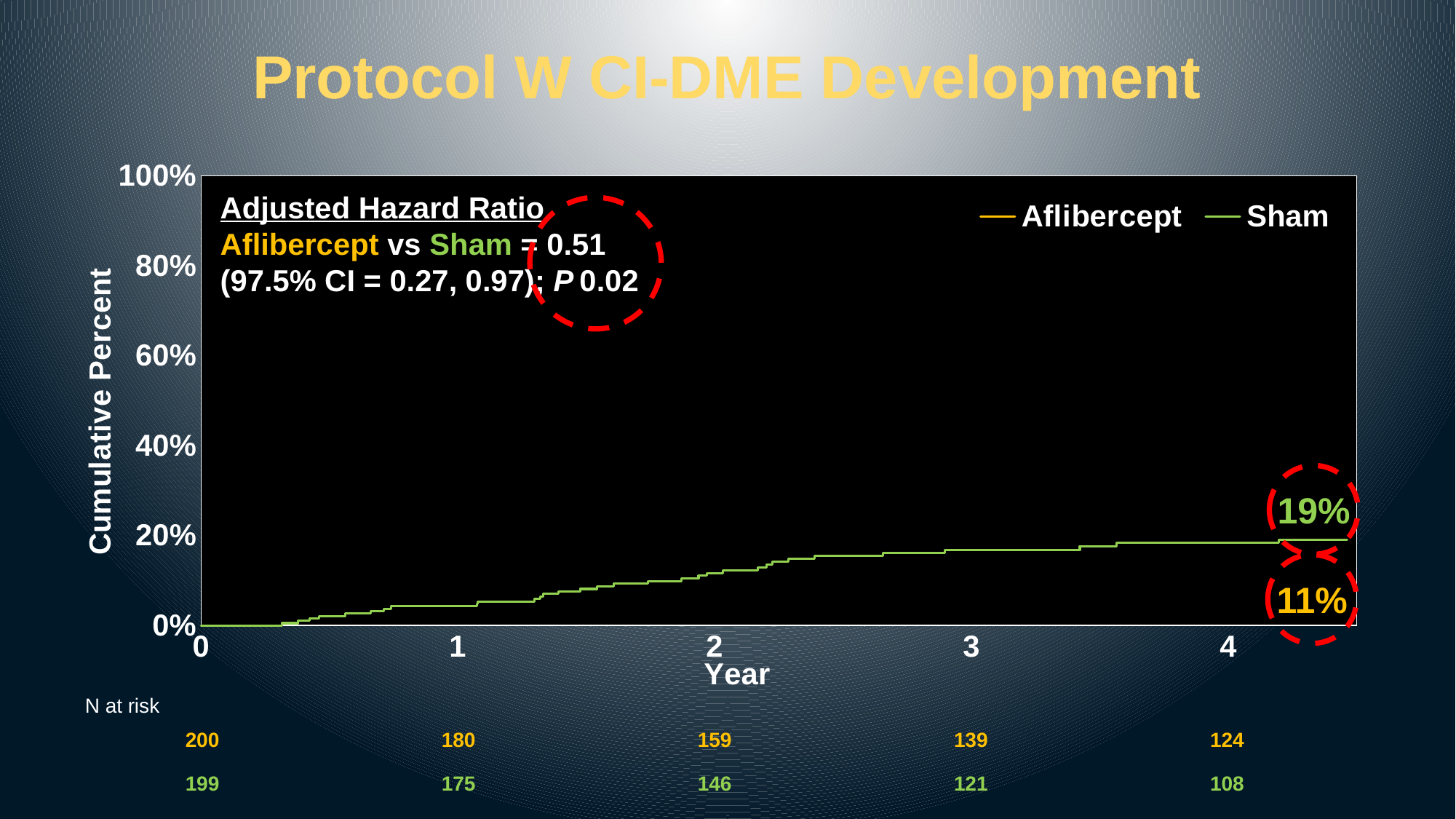
What adjusted hazard ratio is shown for Aflibercept vs Sham? 0.51 What is the difference between the final labelled cumulative percent for Sham and for Aflibercept? 8% What is the title of the chart? Protocol W CI-DME Development What kind of chart is shown on the slide? line chart Which group has the higher final labelled cumulative percent, Aflibercept or Sham? Sham What is the N at risk for Sham at Year 4? 108 Is the Sham cumulative percent at Year 2 greater or less than 20%? less How many series does the legend list? 2 Does the Sham curve rise or fall as Year increases? rise What is the cumulative percent labelled for Aflibercept at the end of follow-up? 11% What is the N at risk for Aflibercept at Year 0? 200 What is the cumulative percent labelled for Sham at the end of follow-up? 19%